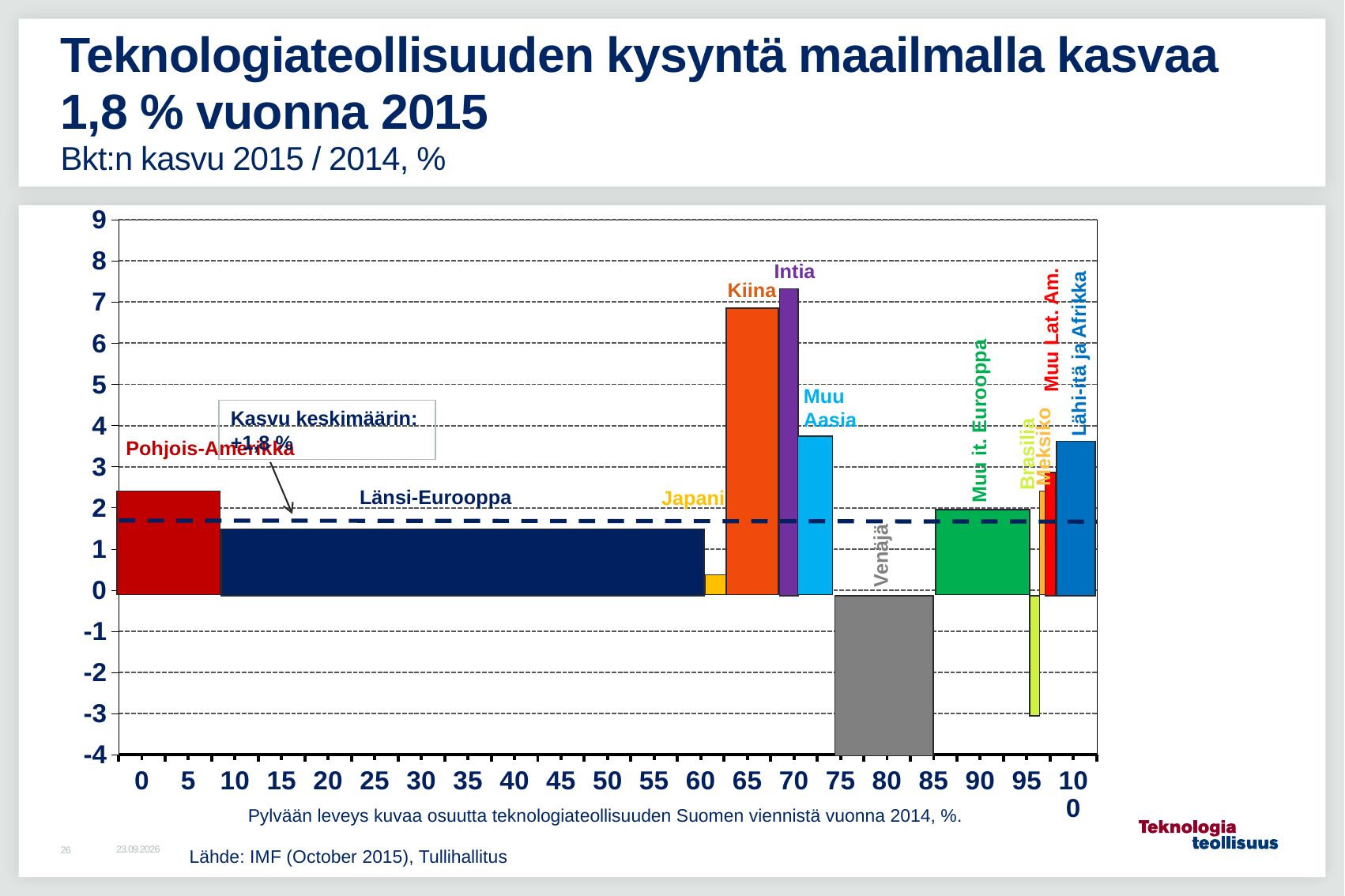
What kind of chart is shown on the slide? bar chart Is the value for Brasilia greater or less than -2? less Is the value for Pohjois-Amerikka greater or less than 2? greater What average growth value is shown by the dashed line annotation? +1,8 % How many regions are shown as bars in the chart? 12 Which region has the lowest GDP growth in the chart? Venäjä Which has the larger value, Kiina or Muu Aasia? Kiina Is the value for Venäjä greater or less than -3? less Which region has the highest GDP growth in the chart? Intia